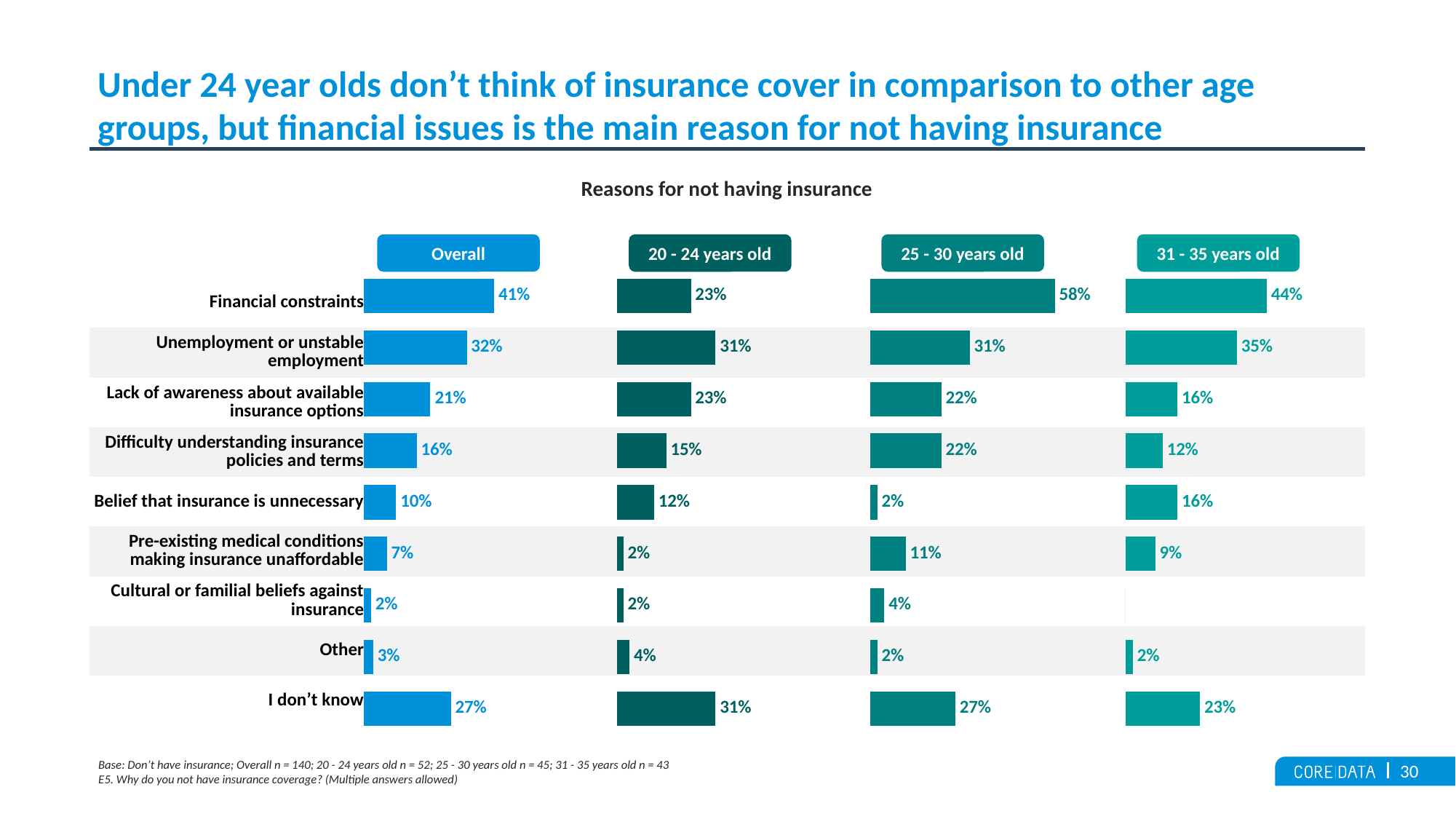
How many reasons (categories) are listed in each chart? 9 What is the title shown above the charts? Reasons for not having insurance In the 25 - 30 years old chart, which reason has the highest percentage? Financial constraints What is the difference between the Financial constraints percentages in the 25 - 30 years old chart and the 20 - 24 years old chart? 35 percentage points In the 20 - 24 years old chart, what percentage is shown for I don't know? 31% Which is larger: Belief that insurance is unnecessary in the 31 - 35 years old chart or in the 25 - 30 years old chart? 31 - 35 years old In the 31 - 35 years old chart, what percentage is shown for Unemployment or unstable employment? 35% In the Overall chart, which reason has the lowest percentage? Cultural or familial beliefs against insurance In the Overall chart, what percentage is shown for Financial constraints? 41% In the 25 - 30 years old chart, what percentage is shown for Financial constraints? 58% What type of chart is used to show the reasons for not having insurance? Bar chart How many age-group charts (including Overall) are shown on the slide? 4